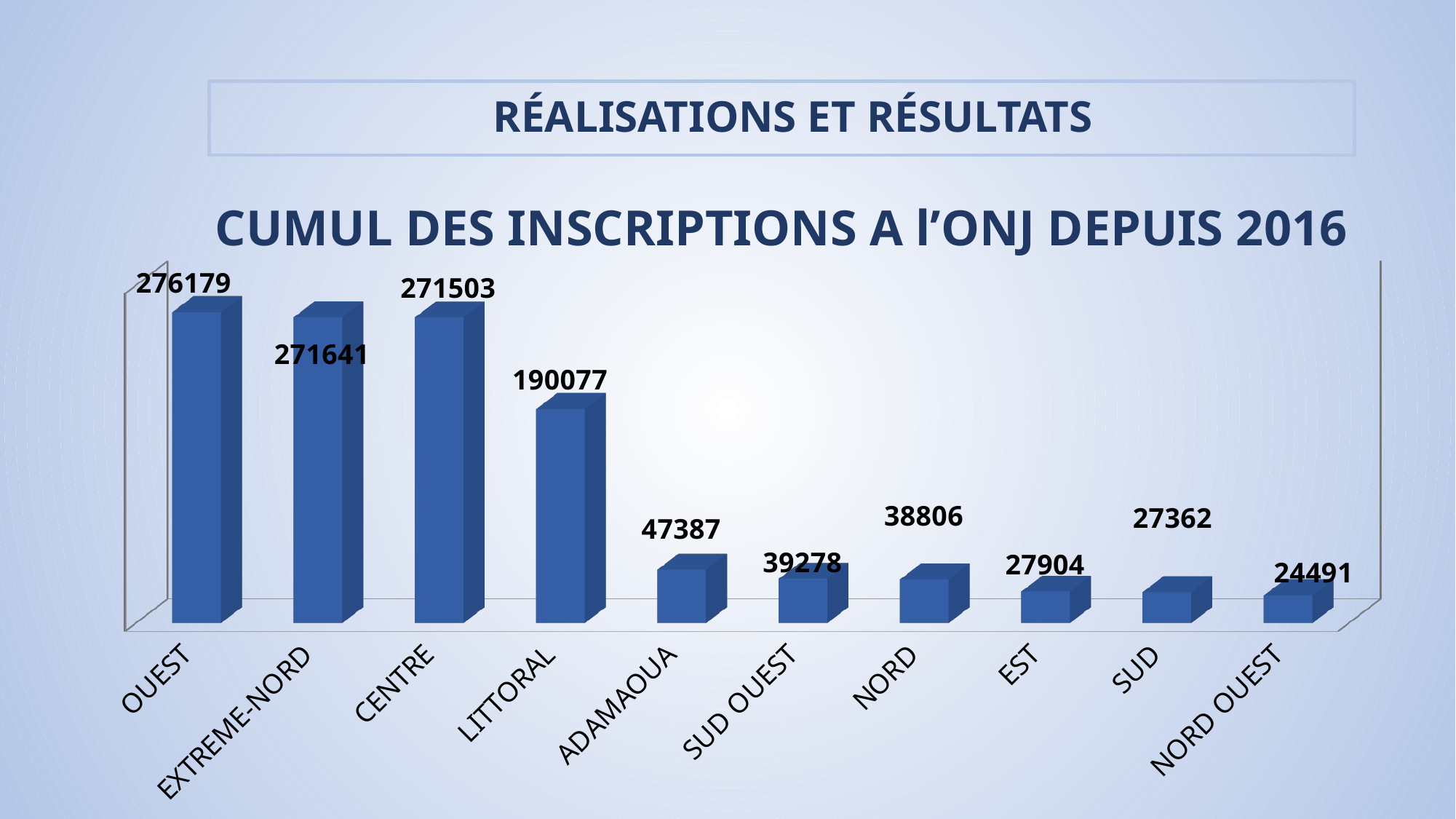
Which region has the lowest value? NORD OUEST What kind of chart is shown on the slide? Bar chart Which region has the highest value? OUEST What is the title of the chart? CUMUL DES INSCRIPTIONS A l'ONJ DEPUIS 2016 Which is larger, the value for EXTREME-NORD or the value for CENTRE? EXTREME-NORD What is the value for ADAMAOUA? 47387 What is the value for NORD OUEST? 24491 What is the difference between the values for OUEST and EXTREME-NORD? 4538 Which is larger, the value for SUD OUEST or the value for NORD? SUD OUEST How many regions are shown on the chart? 10 What is the difference between the values for LITTORAL and ADAMAOUA? 142690 What is the value for LITTORAL? 190077